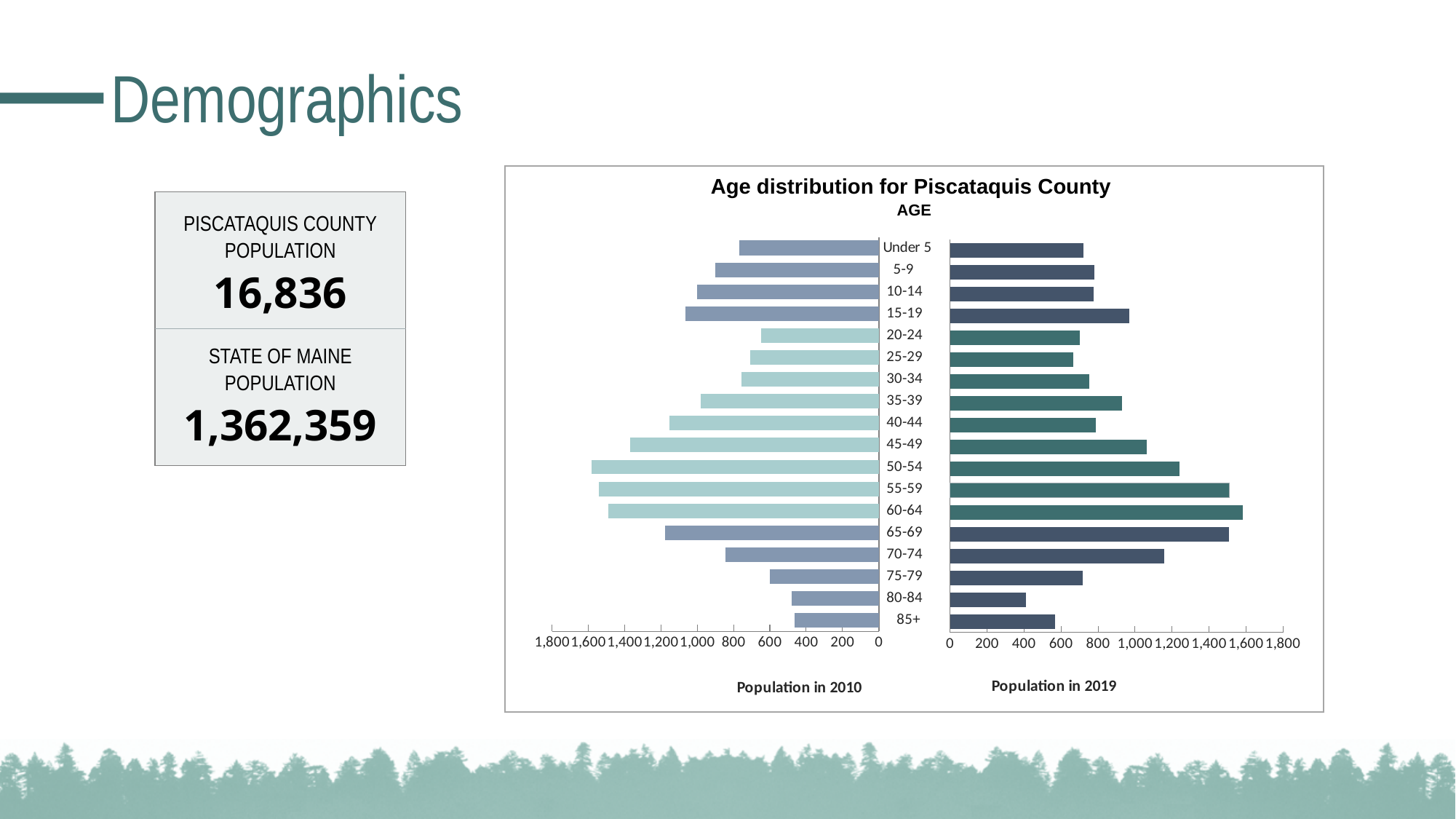
Is the Population in 2010 value for the 50-54 age group greater or less than 1,400? greater How many age groups are shown in the age distribution chart? 18 What kind of chart is used to show the age distribution for Piscataquis County? bar chart In the Population in 2019 side of the chart, which age group has the highest value? 60-64 For the 45-49 age group, which is larger: the Population in 2010 or the Population in 2019? Population in 2010 What is the title of the chart on the slide? Age distribution for Piscataquis County What are the two sides of the age distribution chart labelled? Population in 2010 and Population in 2019 Is the Population in 2019 value for the 70-74 age group greater or less than 1,000? greater In the Population in 2019 side of the chart, which age group has the lowest value? 80-84 Is the Population in 2019 value for the 80-84 age group greater or less than 600? less For the 70-74 age group, which is larger: the Population in 2010 or the Population in 2019? Population in 2019